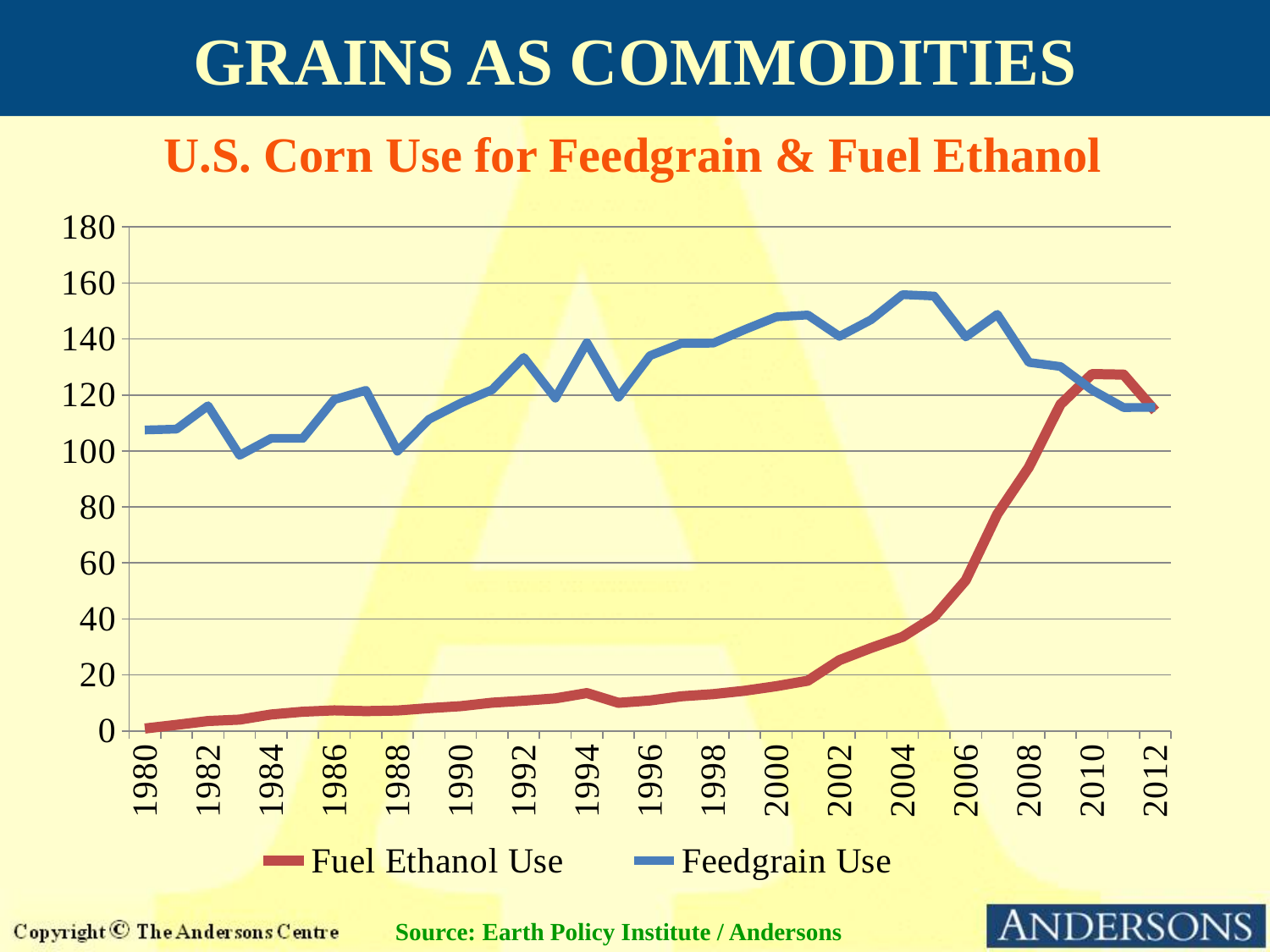
What kind of chart is shown on the slide? line chart What is the last year shown on the x axis? 2012 Is the value for Fuel Ethanol Use in 2010 greater or less than 100? greater How many series does the legend list? 2 Is the value for Fuel Ethanol Use in 1980 greater or less than 20? less Is the value for Feedgrain Use in 1980 greater or less than 120? less In 2000, which series has the larger value, Feedgrain Use or Fuel Ethanol Use? Feedgrain Use Does Feedgrain Use rise or fall between 2005 and 2012? fall Does Fuel Ethanol Use rise or fall between 2000 and 2010? rise What is the title of the chart? U.S. Corn Use for Feedgrain & Fuel Ethanol Which colour is used for the Fuel Ethanol Use line? red